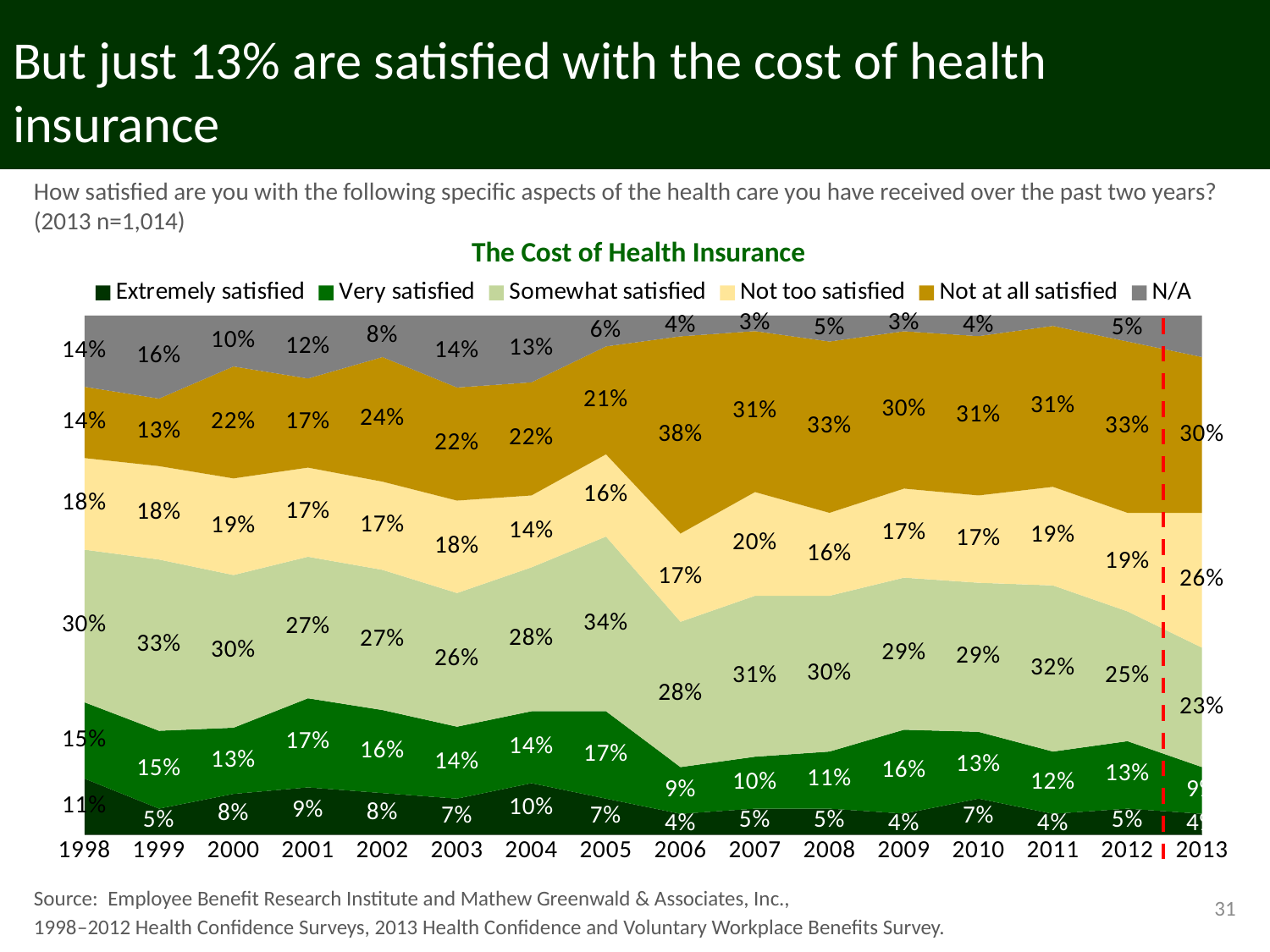
What percentage were 'Not at all satisfied' in 2006? 38% What kind of chart is shown on the slide? Stacked area chart How many years are plotted along the x axis? 16 What percentage were 'Not too satisfied' in 2013? 26% Which year had a larger 'Somewhat satisfied' share, 1999 or 2012? 1999 What percentage were 'Somewhat satisfied' in 2005? 34% What is the title of the chart? The Cost of Health Insurance In which year was the N/A share highest? 1999 In which year was the 'Not at all satisfied' share highest? 2006 By how many percentage points did 'Not at all satisfied' change from 1998 (14%) to 2013 (30%)? 16 percentage points What percentage were 'Extremely satisfied' in 1998? 11% How many series does the legend list? 6